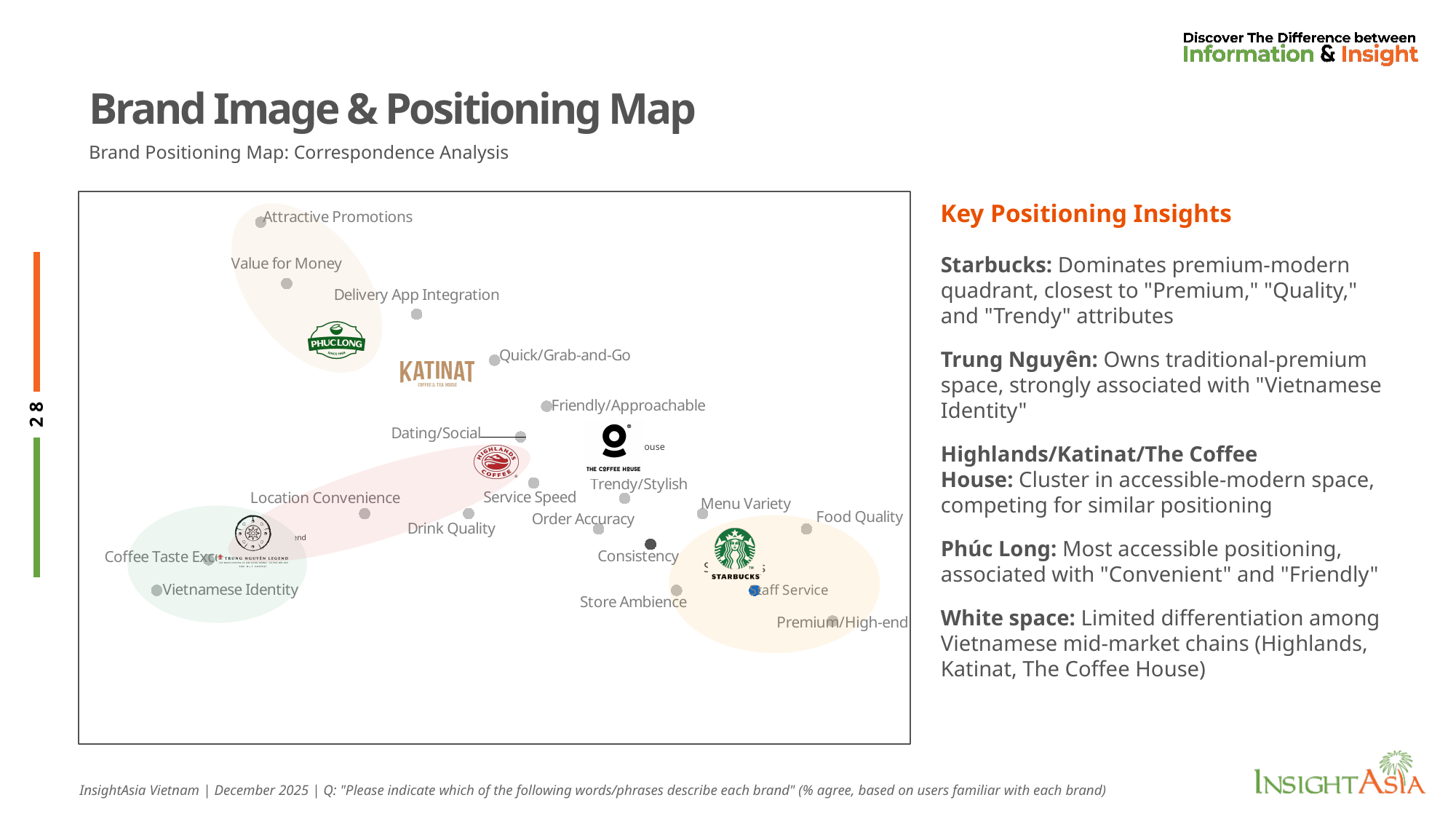
How many brand logos are plotted on the positioning map? 6 Which brand logo is plotted closest to the 'Delivery App Integration' point? Katinat Which attribute point is plotted furthest to the left on the map? Vietnamese Identity Which brand logo is plotted closest to the 'Vietnamese Identity' point? Trung Nguyên Legend What kind of chart is shown on the slide? Scatter plot (perceptual/positioning map) Which attribute point is plotted highest (nearest the top) on the map? Attractive Promotions How many shaded cluster ellipses are drawn on the positioning map? 4 Which brand logo is plotted closest to the 'Premium/High-end' point? Starbucks What is the subtitle of the chart on the slide? Brand Positioning Map: Correspondence Analysis